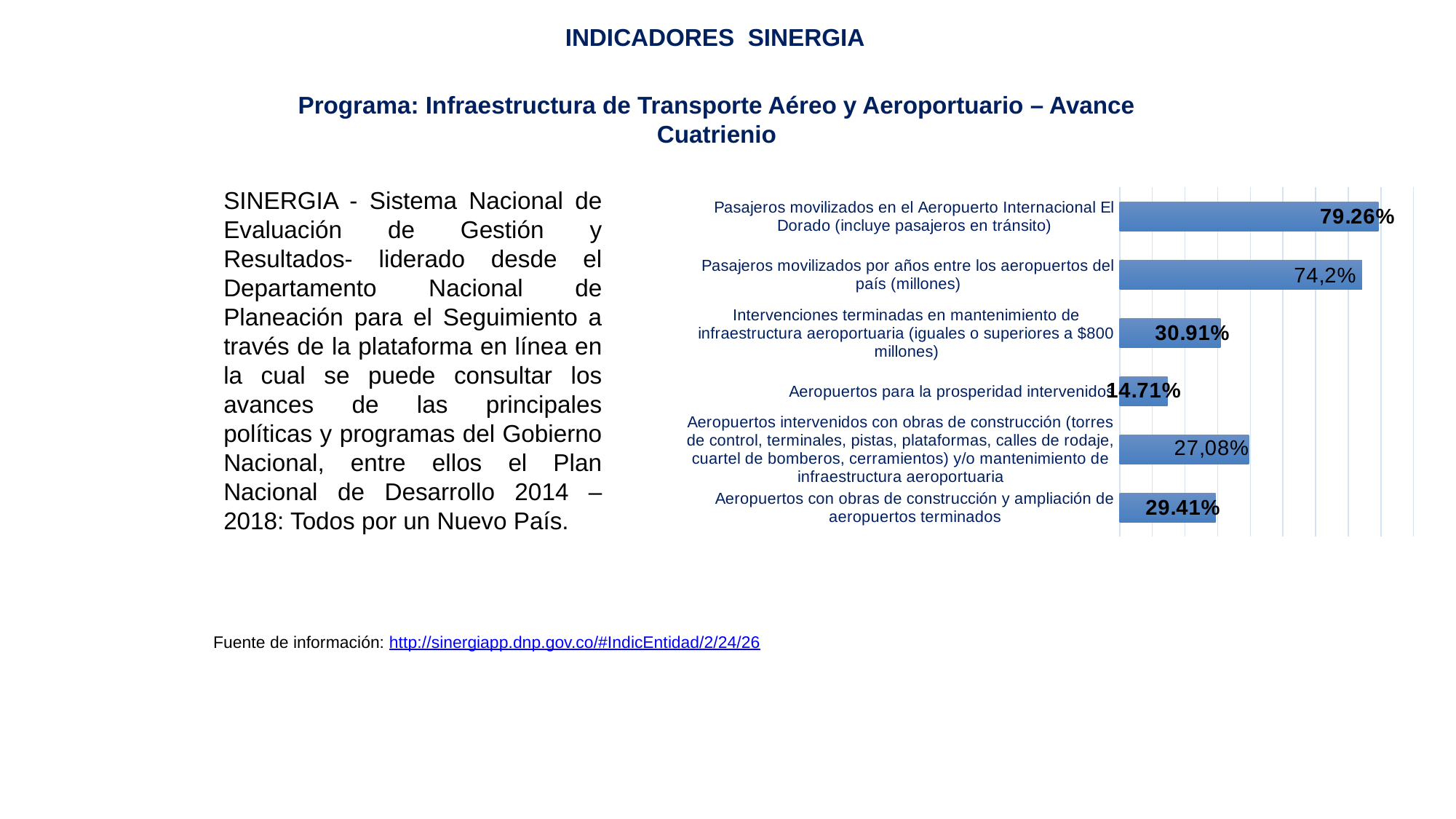
Which indicator has the lowest value in the chart? Aeropuertos para la prosperidad intervenidos What is the difference between the value for 'Pasajeros movilizados en el Aeropuerto Internacional El Dorado' and the value for 'Intervenciones terminadas en mantenimiento de infraestructura aeroportuaria'? 48.35% What is the difference between the value for 'Aeropuertos con obras de construcción y ampliación de aeropuertos terminados' and the value for 'Aeropuertos para la prosperidad intervenidos'? 14.70% What is the value for 'Aeropuertos con obras de construcción y ampliación de aeropuertos terminados'? 29.41% What kind of chart is shown on the slide? Bar chart What is the value for 'Pasajeros movilizados por años entre los aeropuertos del país (millones)'? 74,2% What is the value for 'Intervenciones terminadas en mantenimiento de infraestructura aeroportuaria (iguales o superiores a $800 millones)'? 30.91% What is the value for 'Aeropuertos para la prosperidad intervenidos'? 14.71% What is the value for 'Pasajeros movilizados en el Aeropuerto Internacional El Dorado (incluye pasajeros en tránsito)'? 79.26% Which is larger: the value for 'Intervenciones terminadas en mantenimiento de infraestructura aeroportuaria' or the value for 'Aeropuertos para la prosperidad intervenidos'? Intervenciones terminadas en mantenimiento de infraestructura aeroportuaria Which indicator has the highest value in the chart? Pasajeros movilizados en el Aeropuerto Internacional El Dorado (incluye pasajeros en tránsito) How many categories (indicators) does the bar chart show? 6